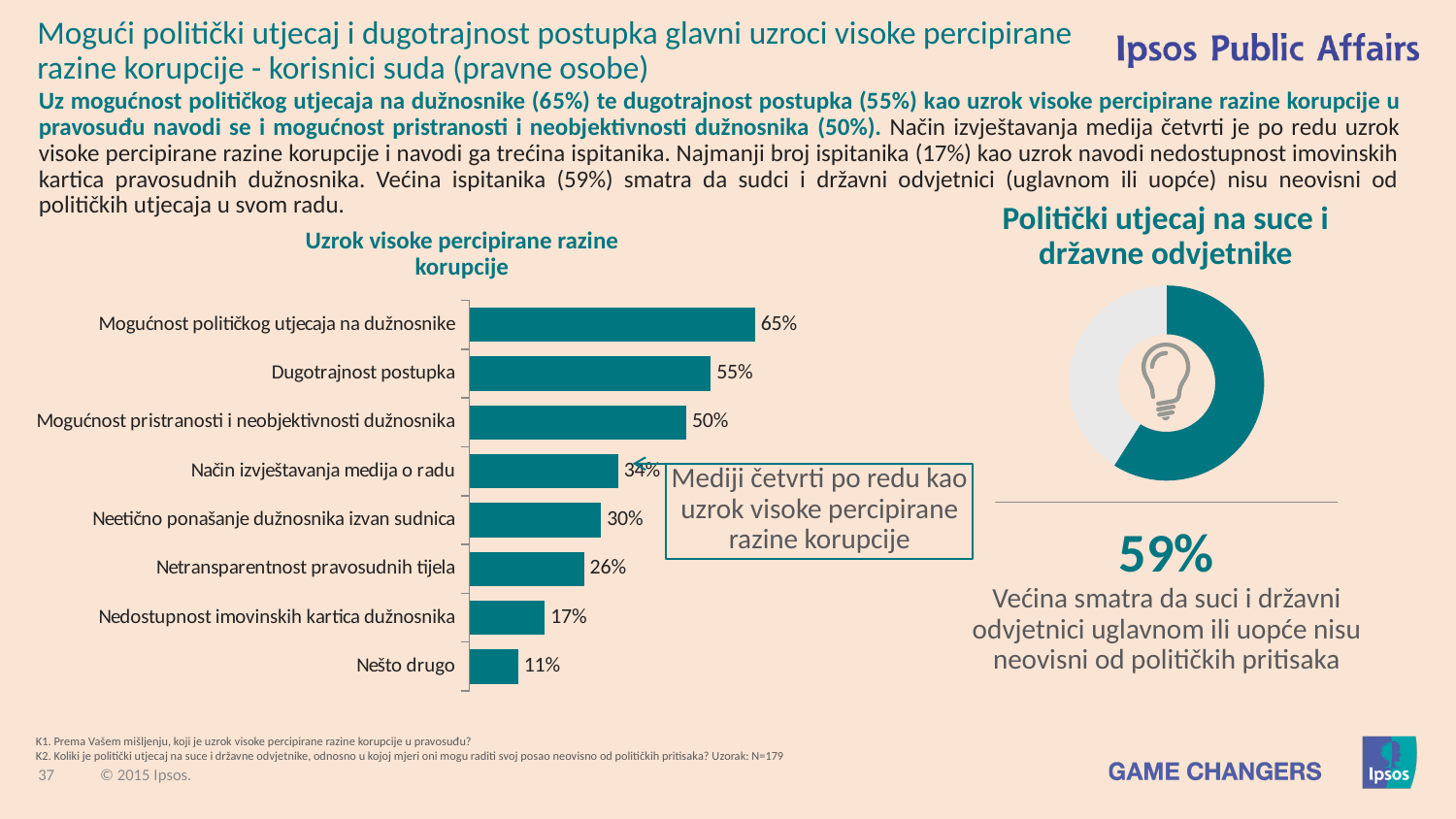
In the chart 'Uzrok visoke percipirane razine korupcije', what is the difference between 'Mogućnost političkog utjecaja na dužnosnike' and 'Dugotrajnost postupka'? 10% What kind of chart is 'Politički utjecaj na suce i državne odvjetnike'? Donut chart In the chart 'Uzrok visoke percipirane razine korupcije', what is the value for 'Nedostupnost imovinskih kartica dužnosnika'? 17% In the chart 'Politički utjecaj na suce i državne odvjetnike', what percentage is shown? 59% In the chart 'Uzrok visoke percipirane razine korupcije', what is the value for 'Dugotrajnost postupka'? 55% What kind of chart is 'Uzrok visoke percipirane razine korupcije'? Bar chart In the chart 'Uzrok visoke percipirane razine korupcije', which category has the lowest value? Nešto drugo In the chart 'Uzrok visoke percipirane razine korupcije', which is larger: 'Neetično ponašanje dužnosnika izvan sudnica' or 'Netransparentnost pravosudnih tijela'? Neetično ponašanje dužnosnika izvan sudnica How many categories are shown in the chart 'Uzrok visoke percipirane razine korupcije'? 8 In the chart 'Uzrok visoke percipirane razine korupcije', which category has the highest value? Mogućnost političkog utjecaja na dužnosnike In the chart 'Uzrok visoke percipirane razine korupcije', what is the value for 'Nešto drugo'? 11% In the chart 'Uzrok visoke percipirane razine korupcije', what is the value for 'Mogućnost političkog utjecaja na dužnosnike'? 65%